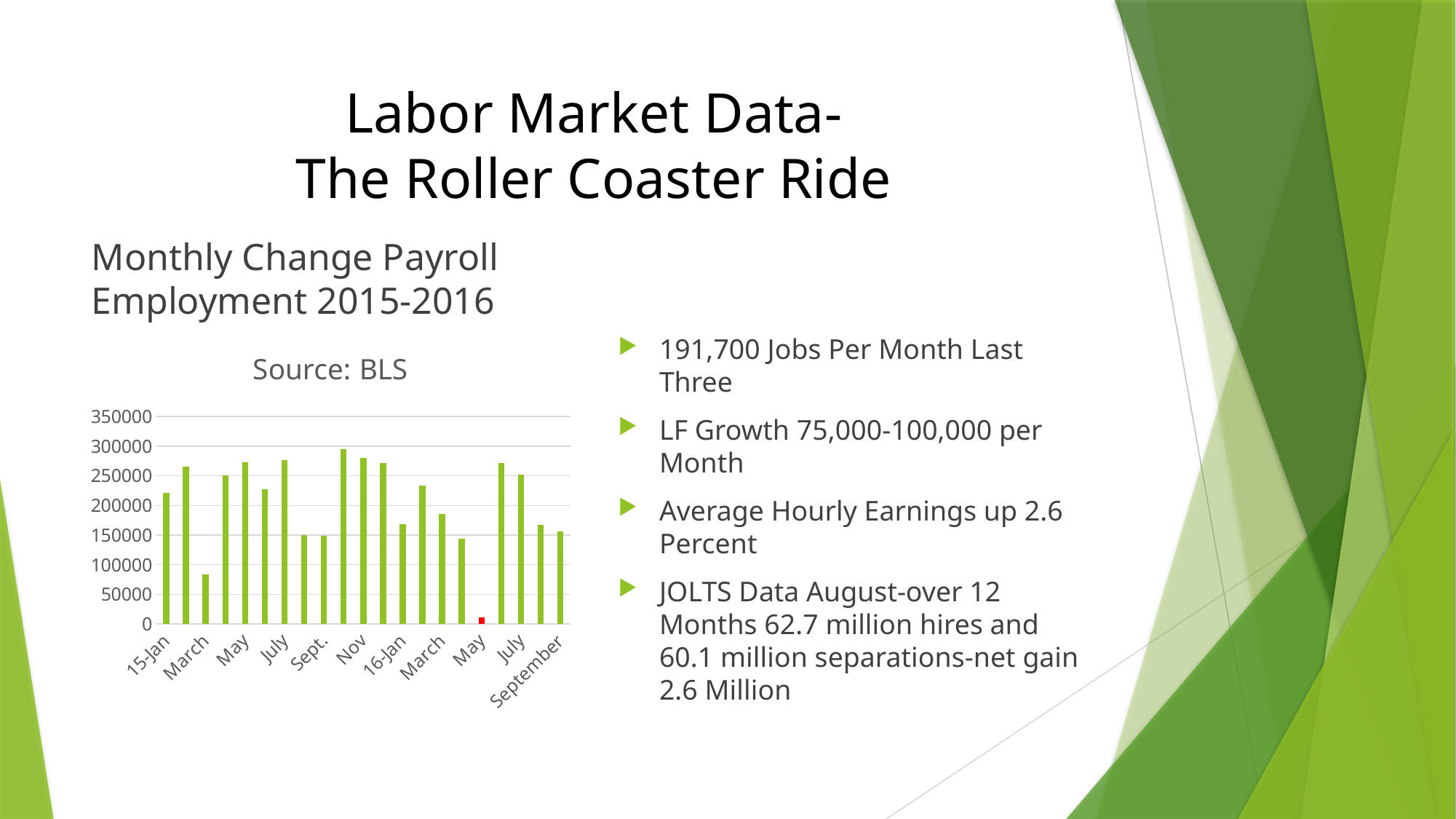
What colour is the bar for May 2016? red How many bars are plotted in the chart? 21 Is the value for 15-Jan greater or less than 200000? greater Is the value for July 2016 (the second July) greater or less than 200000? greater What is the title shown above the chart? Source: BLS Is the value for March 2016 (the second March) greater or less than 200000? less What kind of chart is shown on the slide? bar chart Which is larger, the value for Nov or the value for 16-Jan? Nov Which month has the lowest bar in the chart? May (2016) Which is larger, the value for 15-Jan or the value for March 2015? 15-Jan